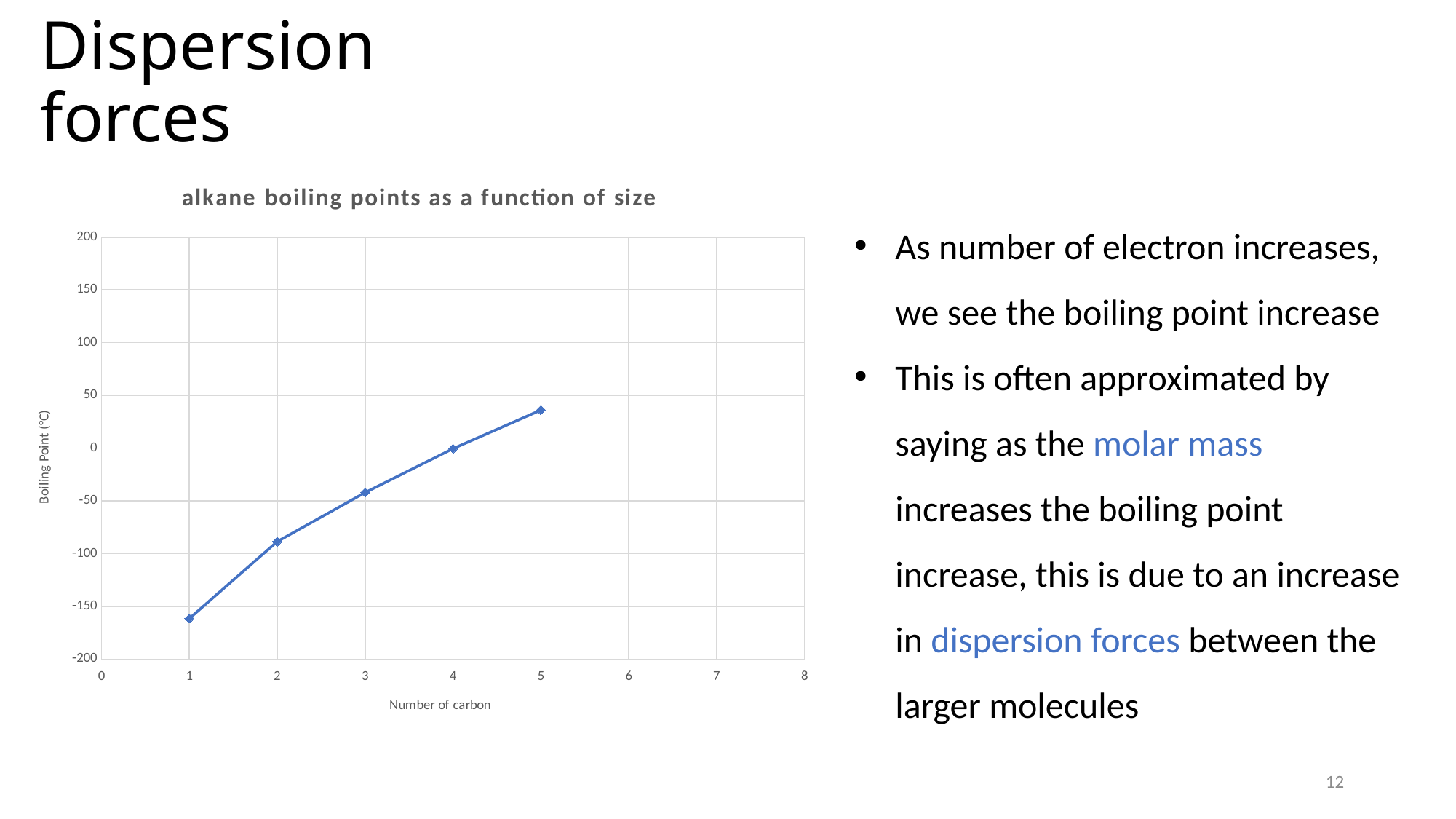
Which number of carbon has the lowest boiling point on the chart? 1 Is the boiling point for 2 carbons greater or less than -50? less How many data points are plotted on the chart? 5 Is the boiling point for 1 carbon greater or less than -150? less Is the boiling point for 3 carbons greater or less than 0? less Do the boiling points rise or fall as the number of carbon increases? rise What is the label of the x axis of the chart? Number of carbon What is the title of the chart? alkane boiling points as a function of size Which number of carbon has the highest boiling point on the chart? 5 What kind of chart is shown on the slide? line chart